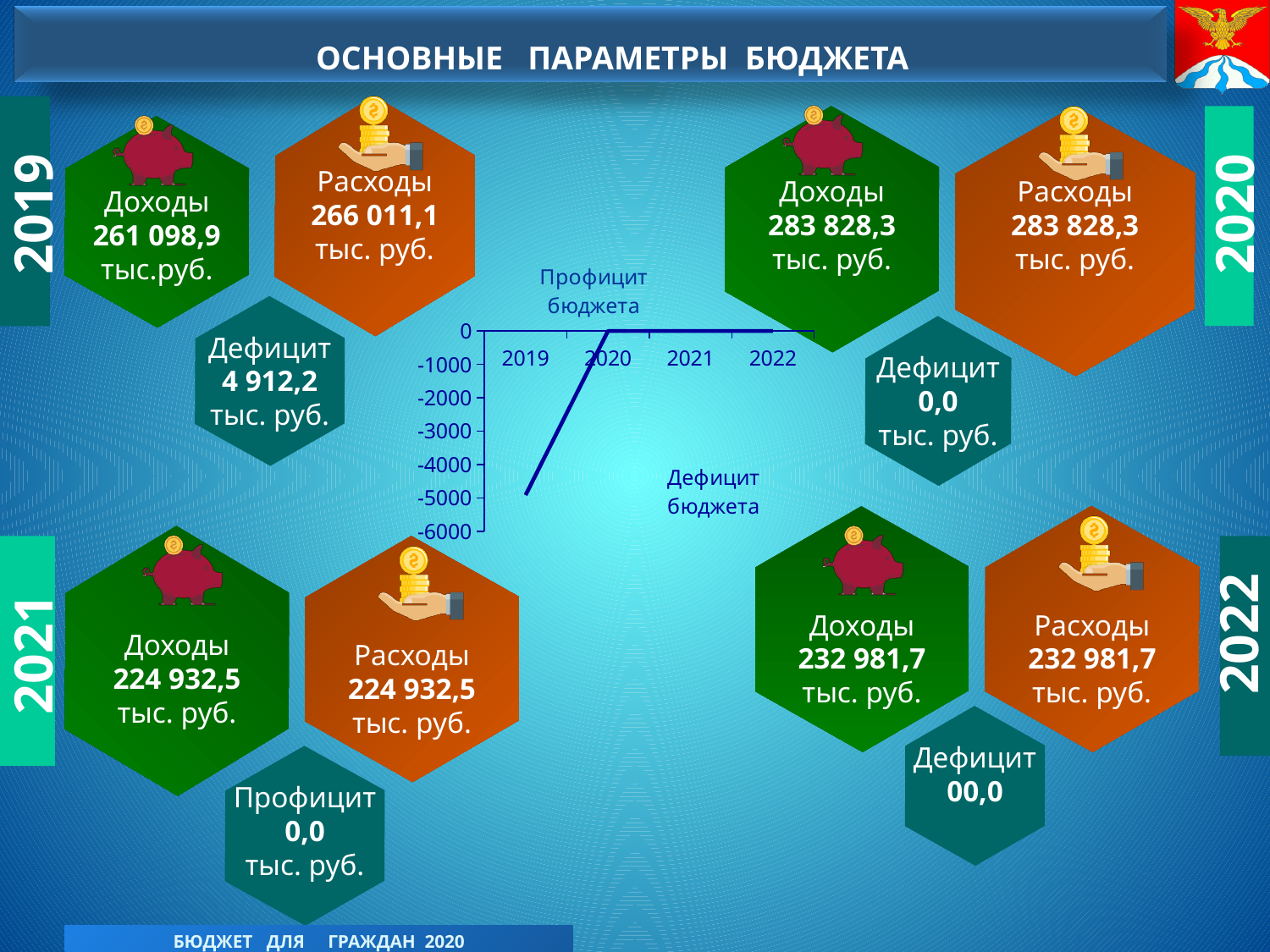
What value does the line chart show for 2022? 0 What kind of chart is shown in the centre of the slide? line chart How many years are shown on the x axis of the line chart? 4 Is the value for 2021 on the line chart greater or less than -1000? greater Which is larger on the line chart, the value for 2019 or the value for 2020? 2020 What is the lowest tick shown on the vertical axis of the line chart? -6000 Is the value for 2019 on the line chart greater or less than -6000? greater Does the line rise or fall from 2019 to 2020? rises Which year has the lowest value on the line chart? 2019 What label appears above the zero line of the line chart? Профицит бюджета What value does the line chart show for 2020? 0 Is the value for 2019 on the line chart greater or less than -4000? less